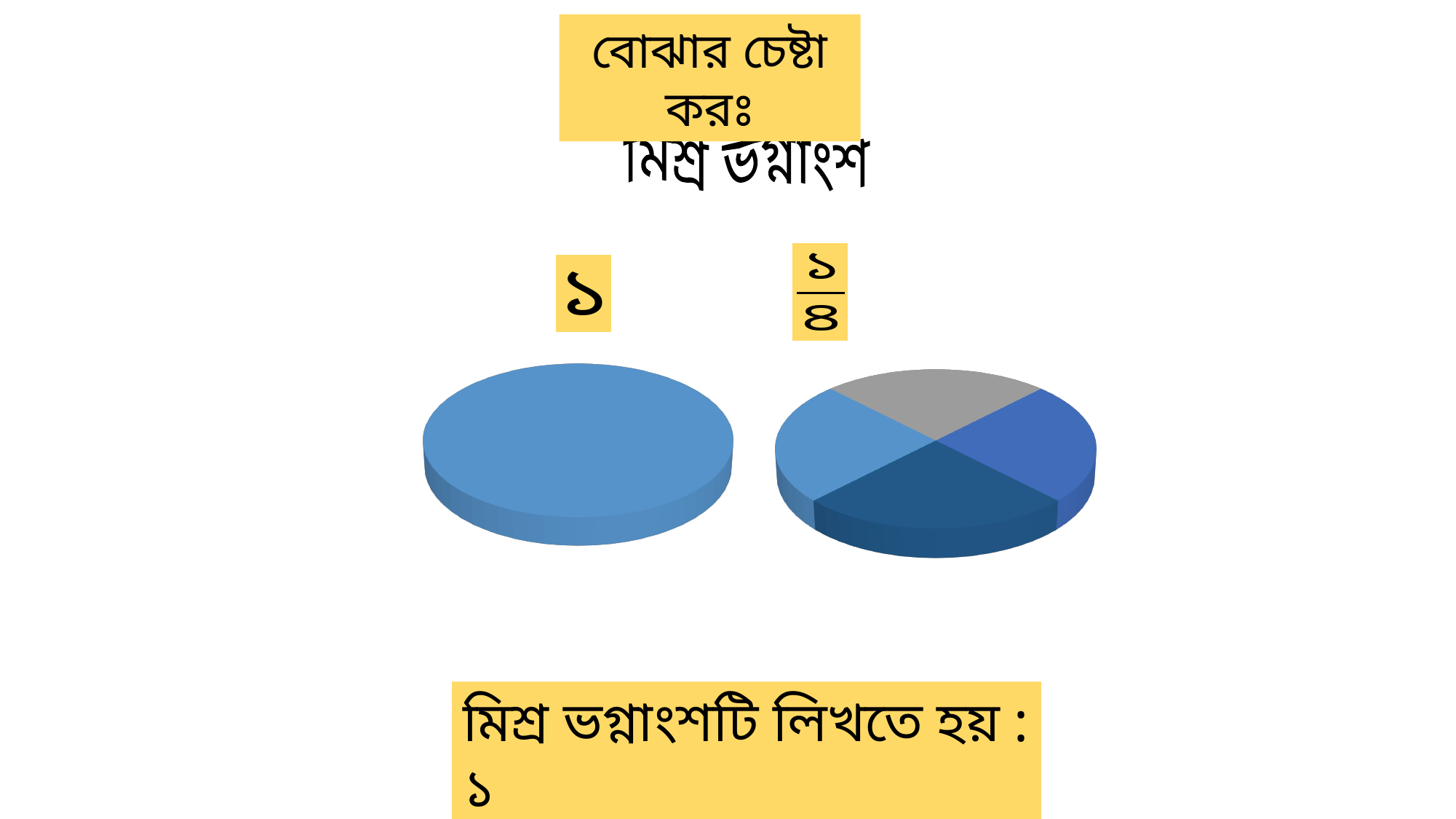
What number is printed in the yellow box above the left pie chart? ১ How many charts are shown on the slide? 2 In the right pie chart, are the four slices equal in size? yes How many slices does the right pie chart have? 4 What share of the right pie chart does each slice represent, according to the label above it? ১/৪ What fraction is printed in the yellow box above the right pie chart? ১/৪ How many slices does the left pie chart have? 1 What kind of chart is shown on the right of the slide? pie chart What kind of chart is shown on the left of the slide? pie chart